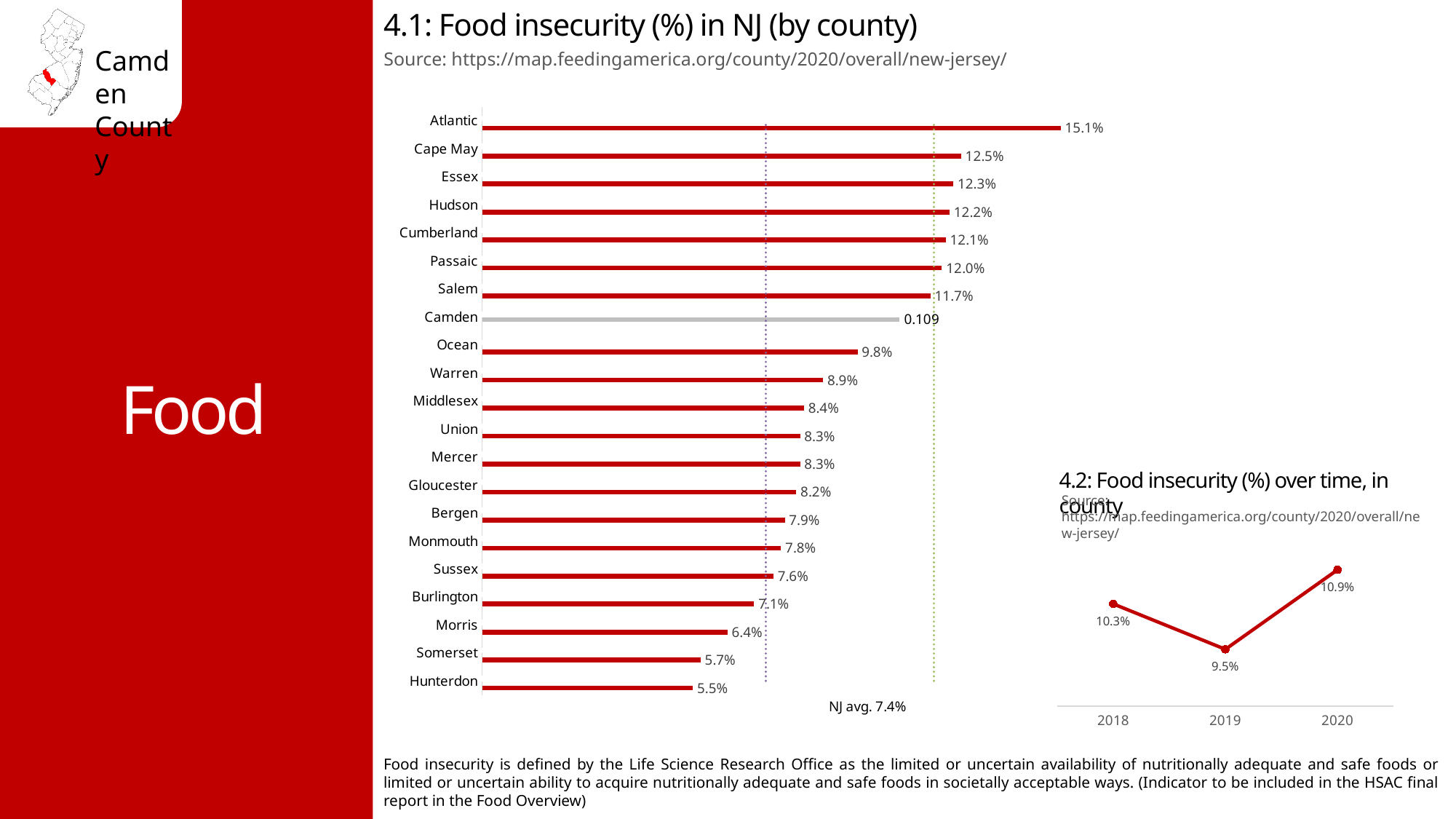
In chart 4.1, what data label is shown for Camden? 0.109 In chart 4.1, which county has the lowest food insecurity value? Hunterdon In chart 4.1, what is the difference between the values for Atlantic and Hunterdon? 9.6% In chart 4.1, what is the food insecurity value for Atlantic? 15.1% In chart 4.1, which county has the highest food insecurity value? Atlantic In chart 4.1, how many counties are plotted? 21 In chart 4.2 (Food insecurity (%) over time, in county), what kind of chart is used? line chart In chart 4.2, what is the value for 2019? 9.5% In chart 4.1, what NJ average value is noted below the chart? NJ avg. 7.4% In chart 4.1, which has the larger value, Ocean or Warren? Ocean In chart 4.1 (Food insecurity (%) in NJ by county), what kind of chart is used? bar chart In chart 4.2, what is the difference between the values for 2020 and 2018? 0.6%